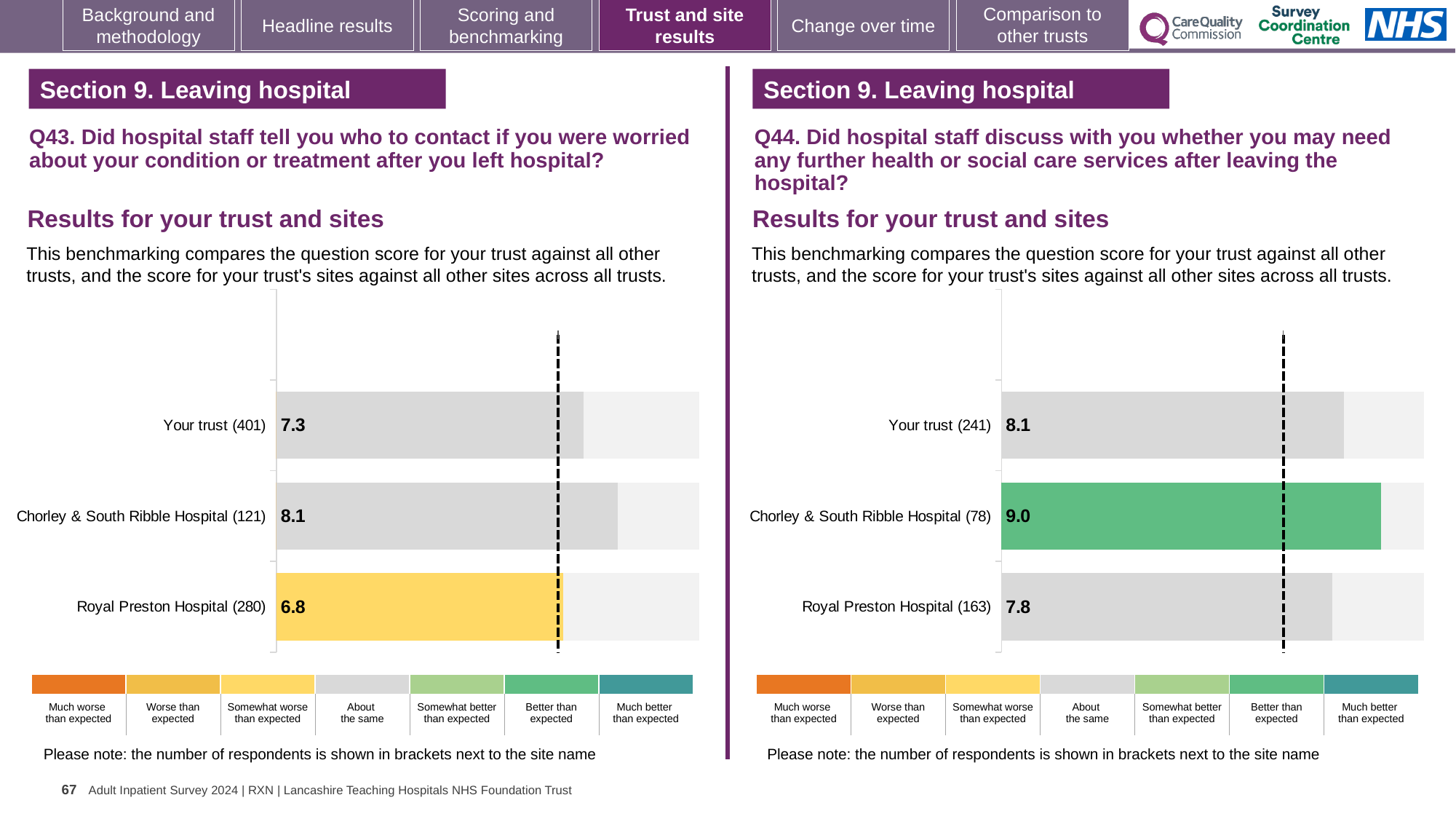
On the Q44 chart (right), what is the score for Chorley & South Ribble Hospital? 9.0 How many bars are plotted on the Q44 chart (right)? 3 On the Q44 chart (right), is the score for Your trust or Chorley & South Ribble Hospital larger? Chorley & South Ribble Hospital On the Q44 chart (right), which site or trust has the lowest score? Royal Preston Hospital On the Q43 chart (left), how many respondents are shown for Royal Preston Hospital? 280 What kind of chart is used on the Q43 chart (left)? Bar chart On the Q43 chart (left), what is the score for Royal Preston Hospital? 6.8 On the Q43 chart (left), what is the score for Your trust? 7.3 On the Q44 chart (right), what is the difference between the scores for Your trust and Royal Preston Hospital? 0.3 On the Q43 chart (left), what is the difference between the scores for Chorley & South Ribble Hospital and Royal Preston Hospital? 1.3 On the Q43 chart (left), which site or trust has the highest score? Chorley & South Ribble Hospital On the Q44 chart (right), what is the score for Royal Preston Hospital? 7.8